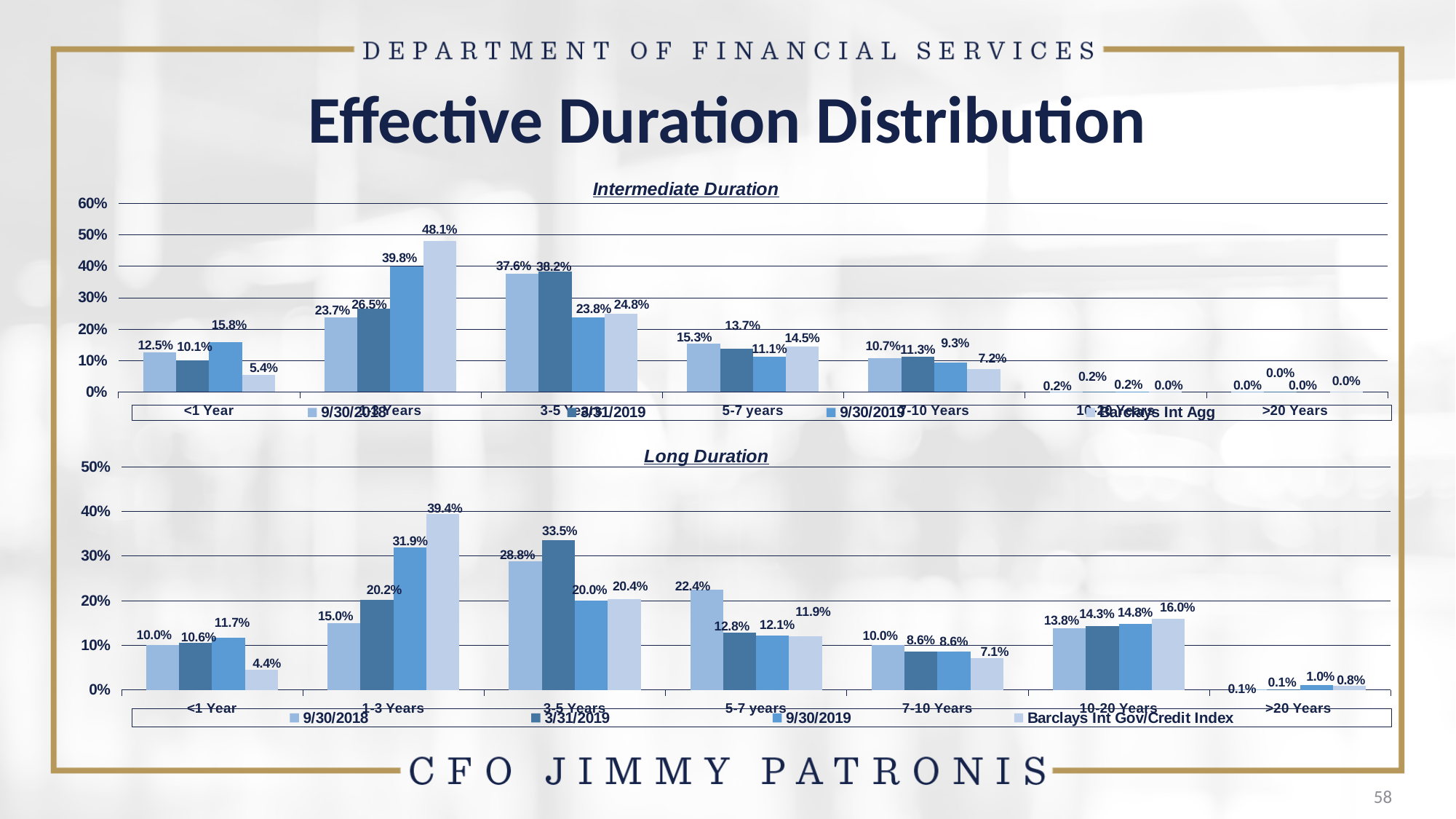
In the Long Duration chart, what is the difference between the Barclays Int Gov/Credit Index value and the 9/30/2018 value for 1-3 Years? 24.4% In the Intermediate Duration chart, what is the Barclays Int Agg value for 1-3 Years? 48.1% In the Long Duration chart, which is larger for 5-7 years: the 9/30/2018 value or the 3/31/2019 value? 9/30/2018 In the Intermediate Duration chart, what is the difference between the 9/30/2019 and 3/31/2019 values for 1-3 Years? 13.3% In the Long Duration chart, which category has the lowest 9/30/2018 value? >20 Years In the Intermediate Duration chart, what is the 9/30/2018 value for 3-5 Years? 37.6% In the Long Duration chart, what is the 3/31/2019 value for 3-5 Years? 33.5% What kind of chart is the Long Duration chart? Bar chart In the Intermediate Duration chart, how many series does the legend list? 4 In the Long Duration chart, what is the Barclays Int Gov/Credit Index value for 10-20 Years? 16.0% In the Intermediate Duration chart, which category has the highest 9/30/2019 value? 1-3 Years In the Long Duration chart, how many categories are shown on the x axis? 7